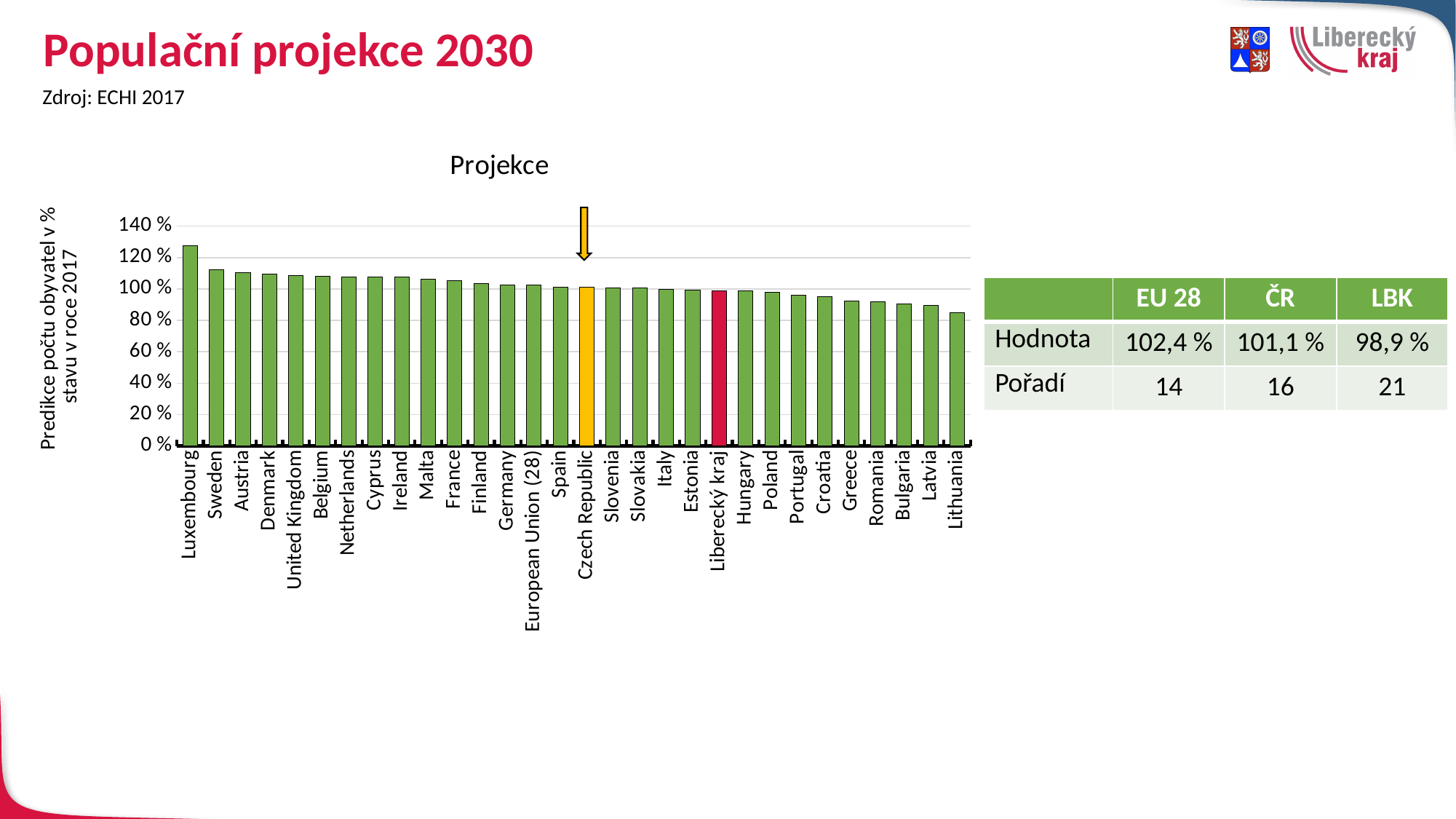
Which is larger, the value for Sweden or the value for Latvia? Sweden Which category has the lowest bar in the chart? Lithuania What kind of chart is shown on the slide? bar chart Is the value for Lithuania greater or less than 100 %? less What colour is the bar for Czech Republic in the chart? yellow According to the table, what is the value (Hodnota) for EU 28? 102,4 % How many bars (categories) are plotted in the chart? 30 Do the bar values rise or fall from left to right along the x axis? fall According to the table, what is the value (Hodnota) for Liberecký kraj (LBK)? 98,9 % What is the title of the chart? Projekce Is the value for Luxembourg greater or less than 120 %? greater Which category has the highest bar in the chart? Luxembourg